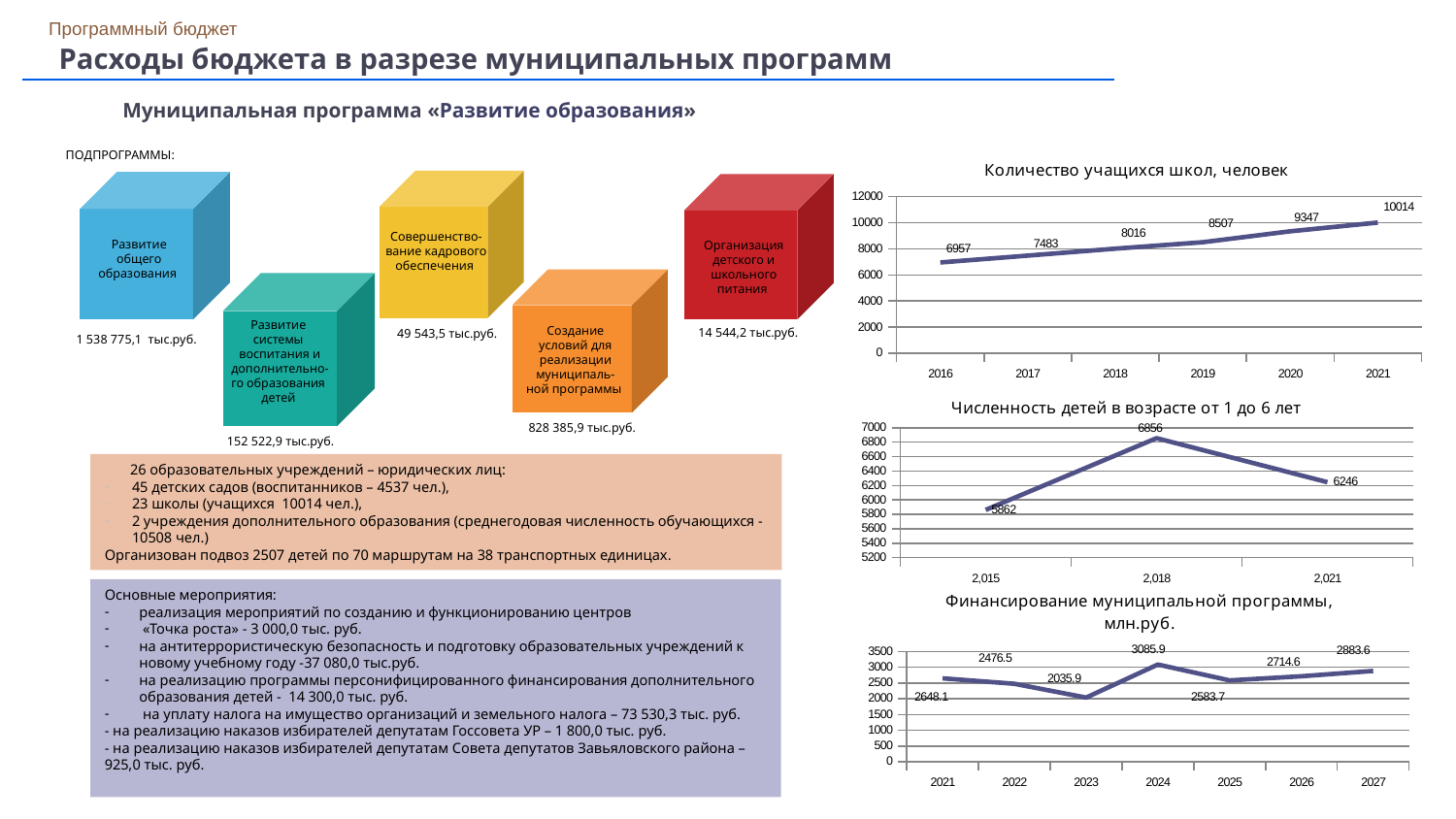
On the chart 'Финансирование муниципальной программы, млн.руб.', what is the value for 2024? 3085.9 How many data points are plotted on the chart 'Количество учащихся школ, человек'? 6 On the chart 'Численность детей в возрасте от 1 до 6 лет', which year has the highest value? 2,018 On the chart 'Финансирование муниципальной программы, млн.руб.', which year has the lowest value? 2023 On the chart 'Количество учащихся школ, человек', what is the value for 2016? 6957 On the chart 'Количество учащихся школ, человек', what is the value for 2021? 10014 On the chart 'Количество учащихся школ, человек', do the values rise or fall from 2016 to 2021? rise What type of chart is 'Финансирование муниципальной программы, млн.руб.'? line chart On the chart 'Численность детей в возрасте от 1 до 6 лет', what is the difference between the 2,018 and 2,015 values? 994 On the chart 'Финансирование муниципальной программы, млн.руб.', which is larger, the value for 2021 or the value for 2022? 2021 On the chart 'Количество учащихся школ, человек', what is the difference between the 2021 and 2016 values? 3057 On the chart 'Численность детей в возрасте от 1 до 6 лет', what is the value for 2,021? 6246